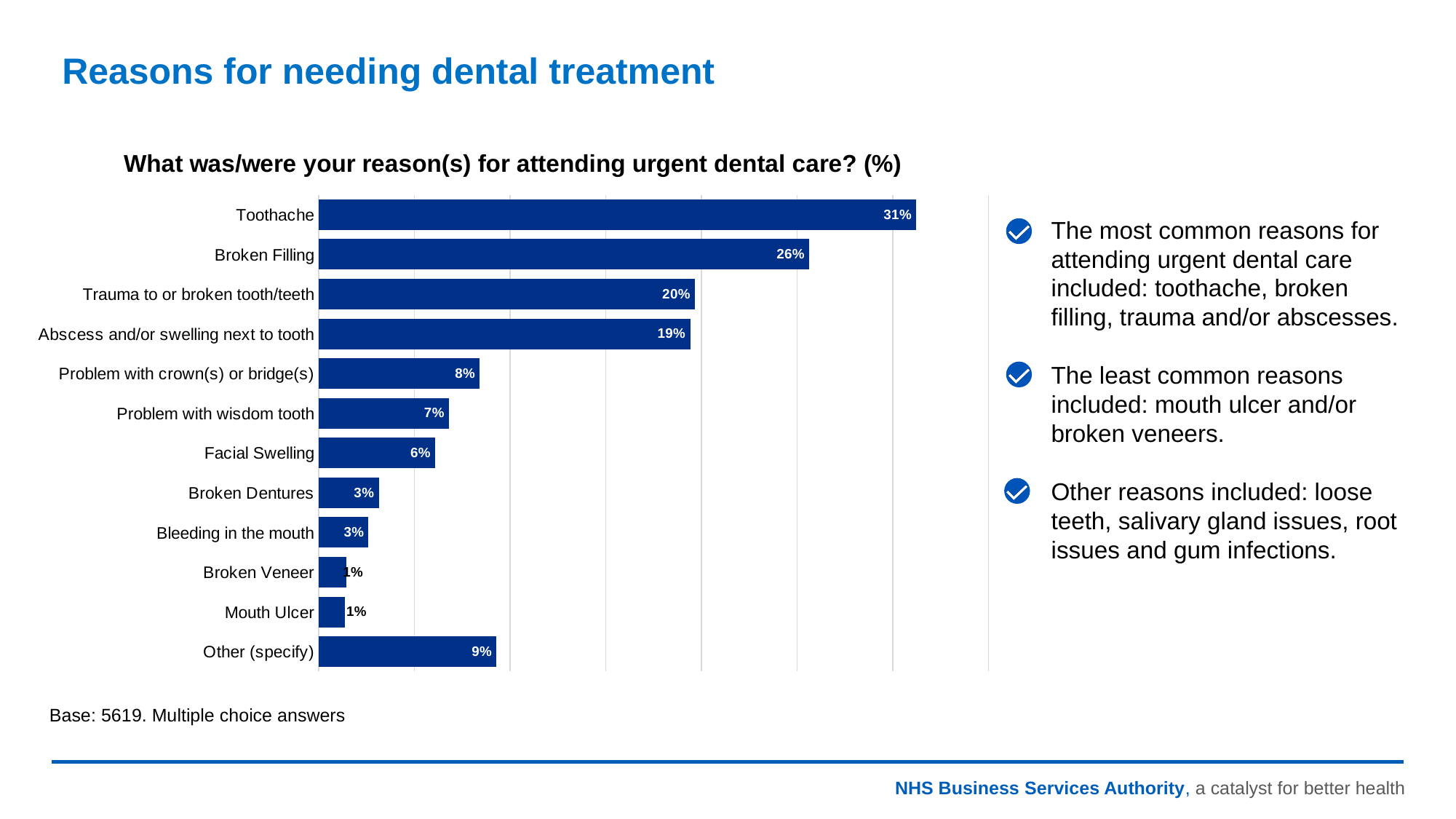
Which is larger, Facial Swelling or Problem with wisdom tooth? Problem with wisdom tooth What type of chart is used on this slide? Bar chart Which reason has the highest percentage? Toothache How many reason categories are shown in the chart? 12 What is the value for Other (specify)? 9% What is the difference in percentage points between Toothache and Broken Filling? 5 What is the value shown for Broken Filling? 26% Which is larger, Other (specify) or Problem with crown(s) or bridge(s)? Other (specify) What is the title of the chart? What was/were your reason(s) for attending urgent dental care? (%) What percentage of respondents gave Toothache as a reason for attending urgent dental care? 31% What is the difference between Trauma to or broken tooth/teeth and Problem with crown(s) or bridge(s)? 12 What percentage is shown for Abscess and/or swelling next to tooth? 19%